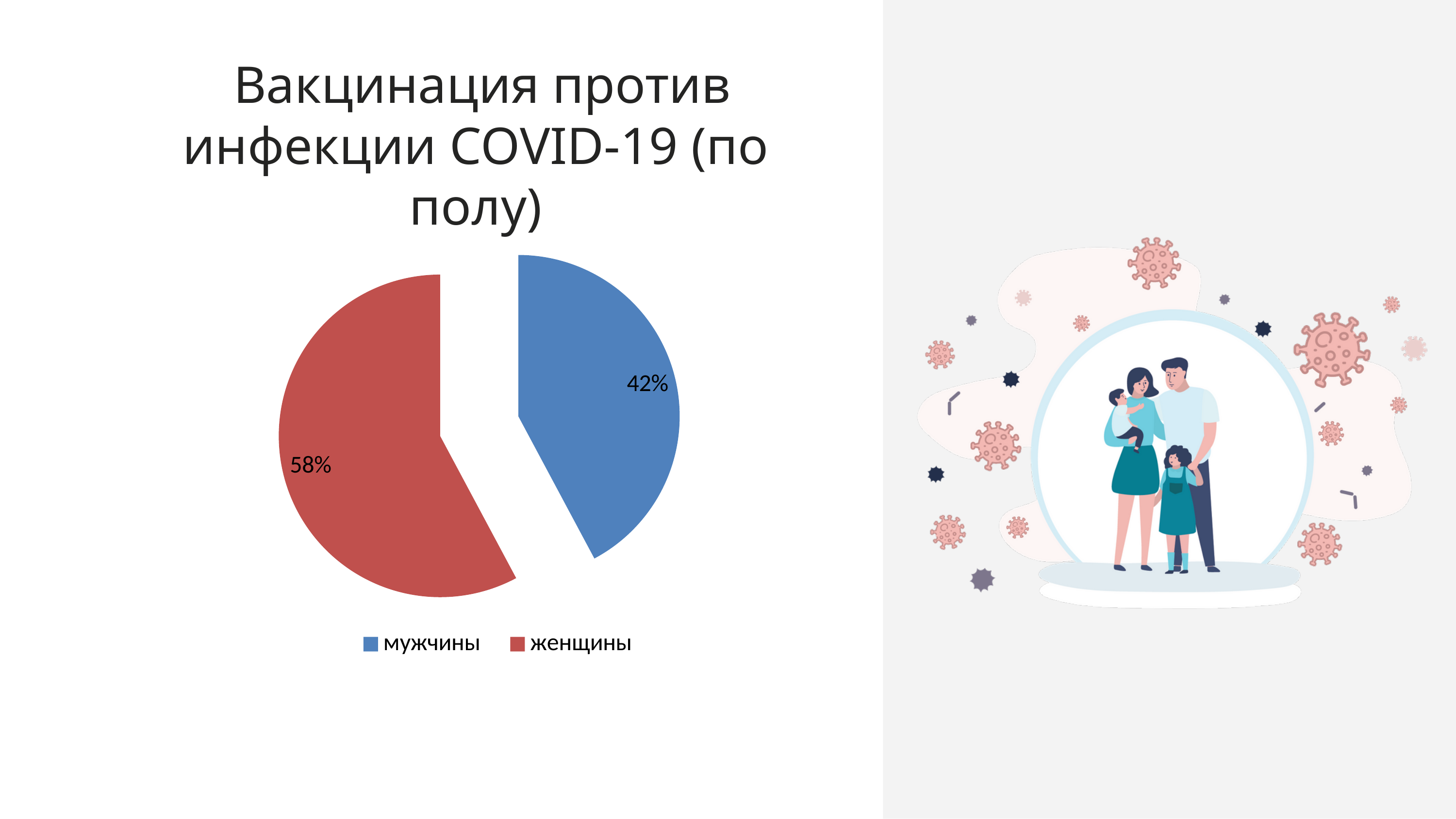
What is the difference in percentage points between the женщины and мужчины slices? 16% What is the title of the chart? Вакцинация против инфекции COVID-19 (по полу) How many slices does the pie chart have? 2 Which category has the largest slice of the pie? женщины How many entries does the legend list? 2 What kind of chart is shown on the slide? pie chart What share of the pie does the женщины slice represent? 58% What share of the pie does the мужчины slice represent? 42% What colour is the женщины slice? red Which category has the smallest slice of the pie? мужчины Which slice is larger, мужчины or женщины? женщины